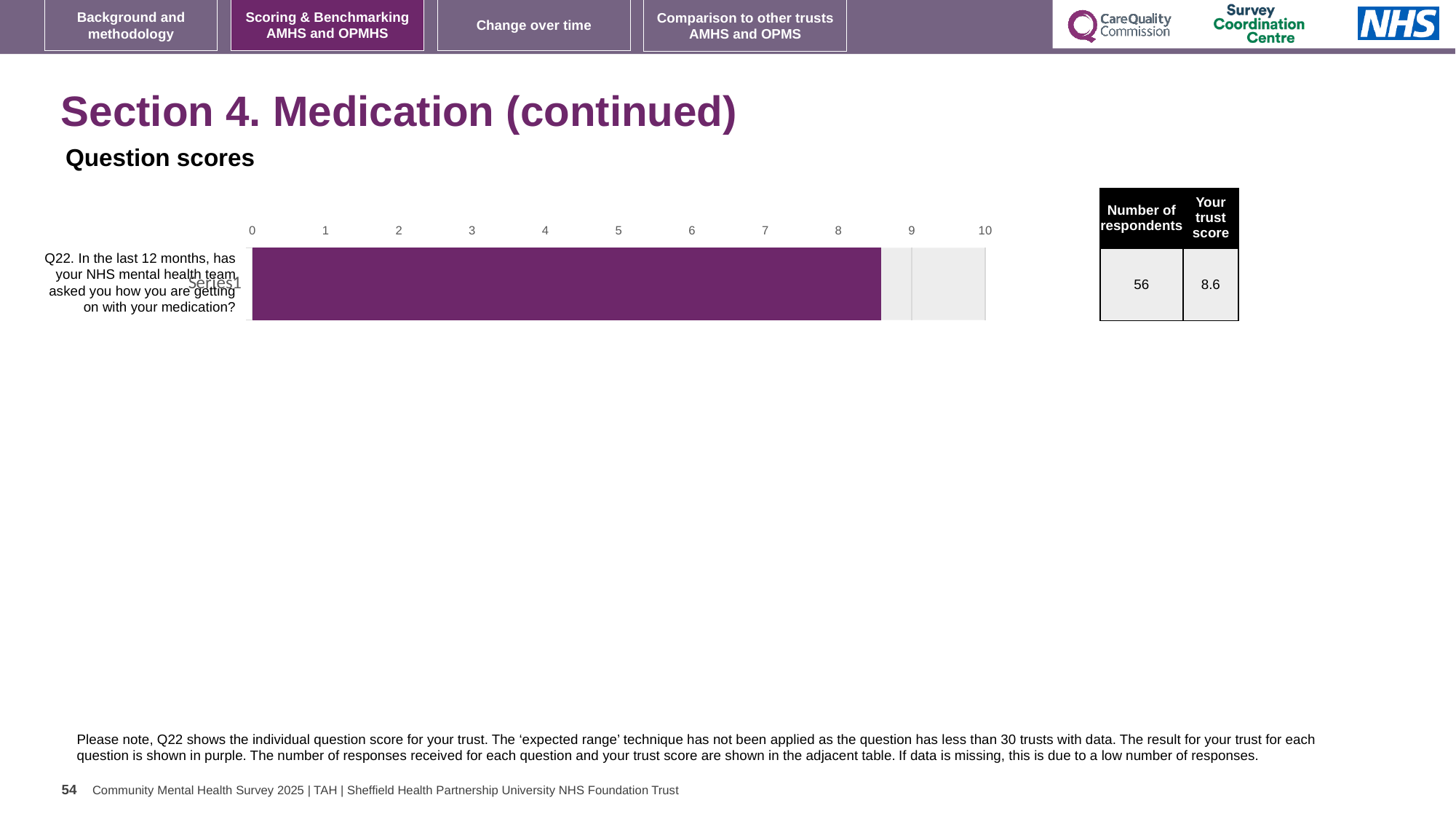
How many bars are plotted in the chart? 1 Is the value of the bar for Q22 greater or less than 8? greater What is the trust score for Q22 shown in the table next to the chart? 8.6 How many respondents are listed for Q22 in the table next to the chart? 56 Is the value of the bar for Q22 greater or less than 9? less Is the value of the bar for Q22 greater or less than 5? greater What colour is the bar for Q22? purple What is the highest value shown on the chart's horizontal axis? 10 What kind of chart is shown on the slide? bar chart